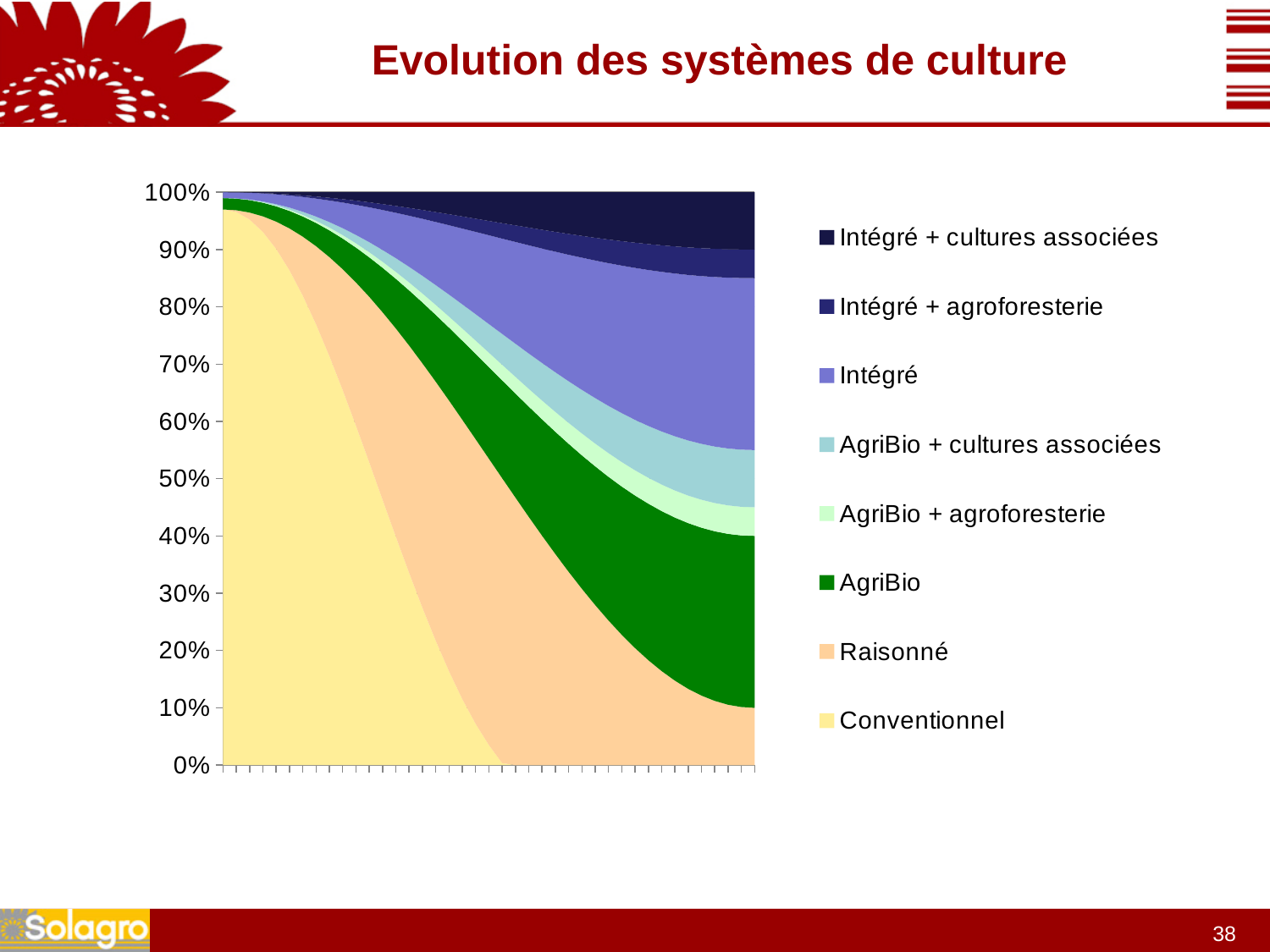
How many series does the legend list? 8 Which series is listed at the bottom of the legend? Conventionnel At the right-hand end of the chart, is the share of AgriBio greater or less than 20%? greater Does the share of AgriBio rise or fall from left to right along the x axis? Rise Does the share of Intégré rise or fall from left to right along the x axis? Rise What kind of chart is shown on the slide? Stacked area chart At the left-hand end of the chart, is the share of Conventionnel greater or less than 90%? greater At the left-hand end of the chart, which series has the largest share? Conventionnel What is the title of the chart? Evolution des systèmes de culture Does the share of Conventionnel rise or fall from left to right along the x axis? Fall At the right-hand end of the chart, which has the larger share, AgriBio or Raisonné? AgriBio At the right-hand end of the chart, is the share of Conventionnel greater or less than 10%? less